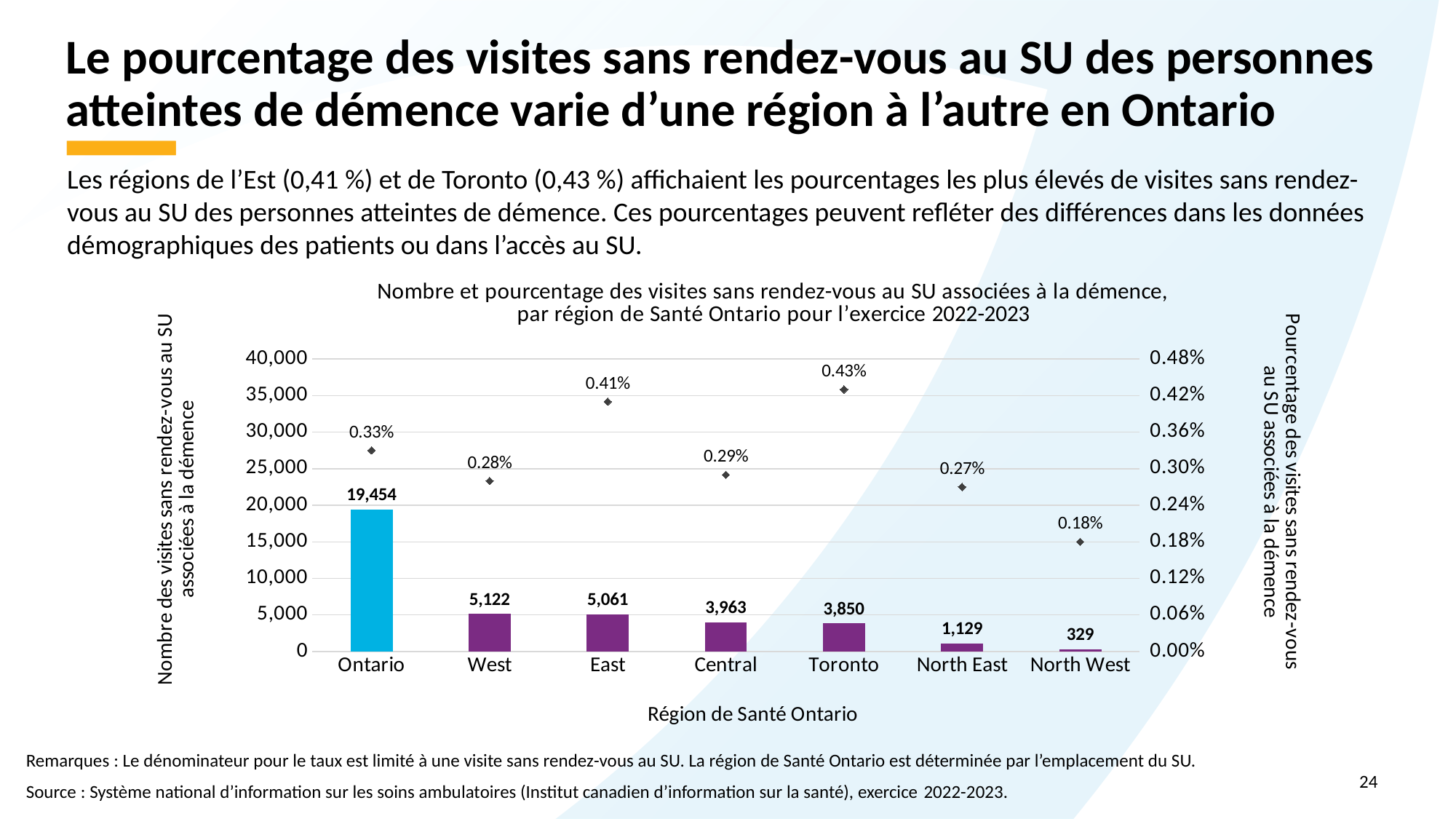
How many regions are shown on the x axis of the chart? 7 Which region has the highest percentage of ER walk-in visits associated with dementia? Toronto What is the number of ER walk-in visits associated with dementia for the West region? 5,122 What is the number of visits shown for North West? 329 Among the regions other than Ontario, which has the highest number of visits? West Which has a higher percentage of dementia-associated visits, East or Central? East What is the label of the x axis of the chart? Région de Santé Ontario Which region has the lowest number of ER walk-in visits associated with dementia? North West Is the number of visits for Ontario greater or less than 15,000? greater What percentage of ER walk-in visits are associated with dementia in the Toronto region? 0.43% What kind of chart is used to show the number of visits by region? bar chart What is the difference in the number of visits between West and East? 61